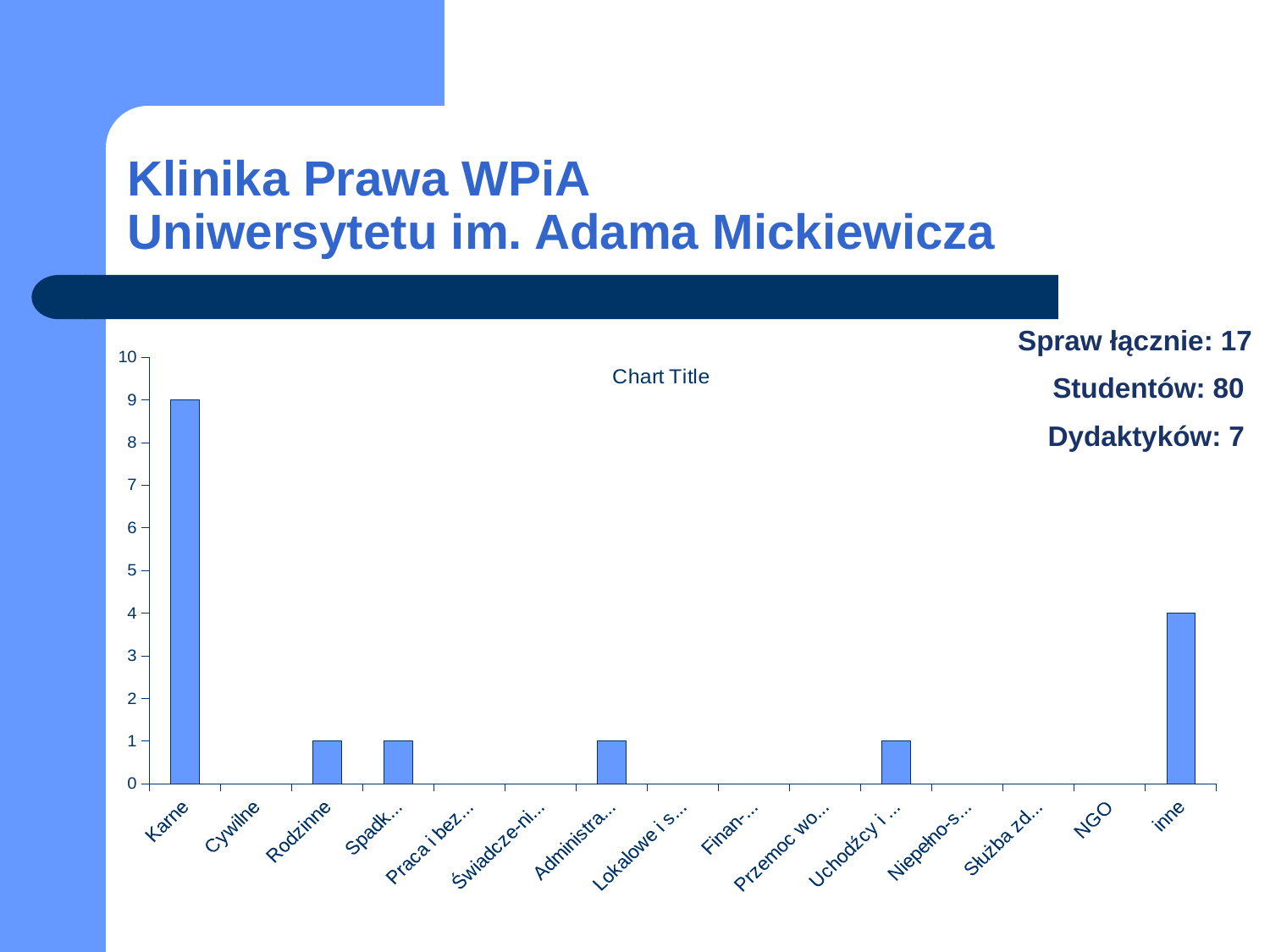
What is the difference between the values for Karne and inne? 5 What type of chart is shown on the slide? bar chart Which category has the highest value? Karne What is the value for NGO? 0 Is the value for Karne greater or less than 5? greater How many categories are shown on the x axis? 15 What is the value for Cywilne? 0 What is the title shown on the chart? Chart Title Which is larger, the value for Karne or the value for inne? Karne What is the value for Karne? 9 What is the value for inne? 4 What is the value for Rodzinne? 1